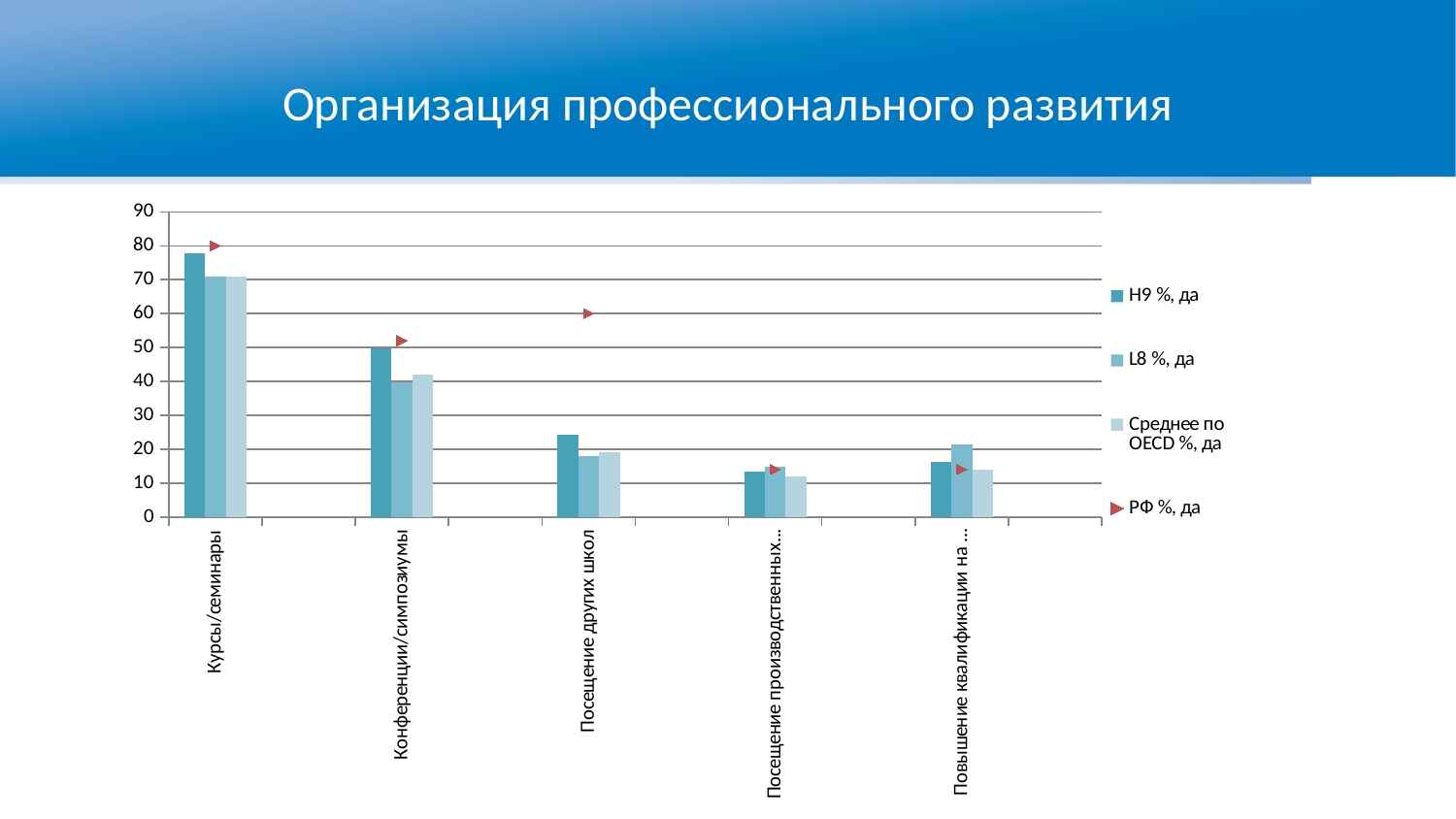
Is the РФ %, да value for Посещение других школ greater or less than 50? greater Which is larger for the H9 %, да series: Курсы/семинары or Конференции/симпозиумы? Курсы/семинары Is the H9 %, да value for Посещение других школ greater or less than 30? less Which legend entry is shown with a triangular marker instead of a bar? РФ %, да How many categories are shown on the x axis? 5 For the category Повышение квалификации на ..., which is larger: L8 %, да or Среднее по OECD %, да? L8 %, да Is the H9 %, да value for Курсы/семинары greater or less than 70? greater How many series does the legend list? 4 Which category has the highest value for the H9 %, да series? Курсы/семинары What is the title of the slide? Организация профессионального развития What kind of chart is shown on the slide? bar chart